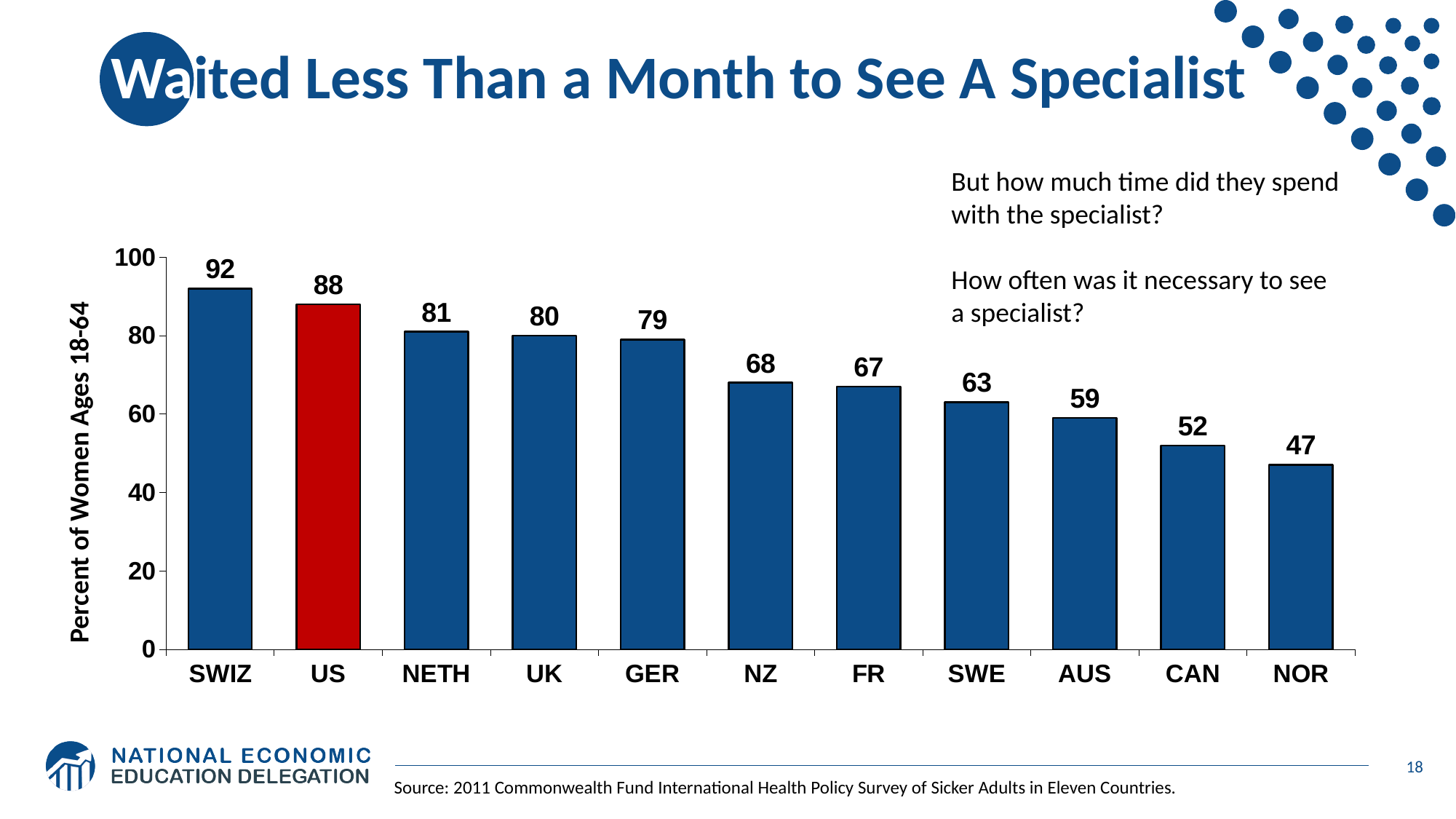
Which country has the highest value? SWIZ Which bar is coloured red rather than blue? US What is the difference between the values for NETH and CAN? 29 How many countries are shown on the chart? 11 What is the value for the US? 88 What is the value for NOR? 47 Is the value for AUS greater or less than 60? less Which country has the lowest value? NOR Which has a larger value, NZ or SWE? NZ What is the value for GER? 79 What kind of chart is shown on the slide? bar chart What is the difference between the values for SWIZ and the US? 4